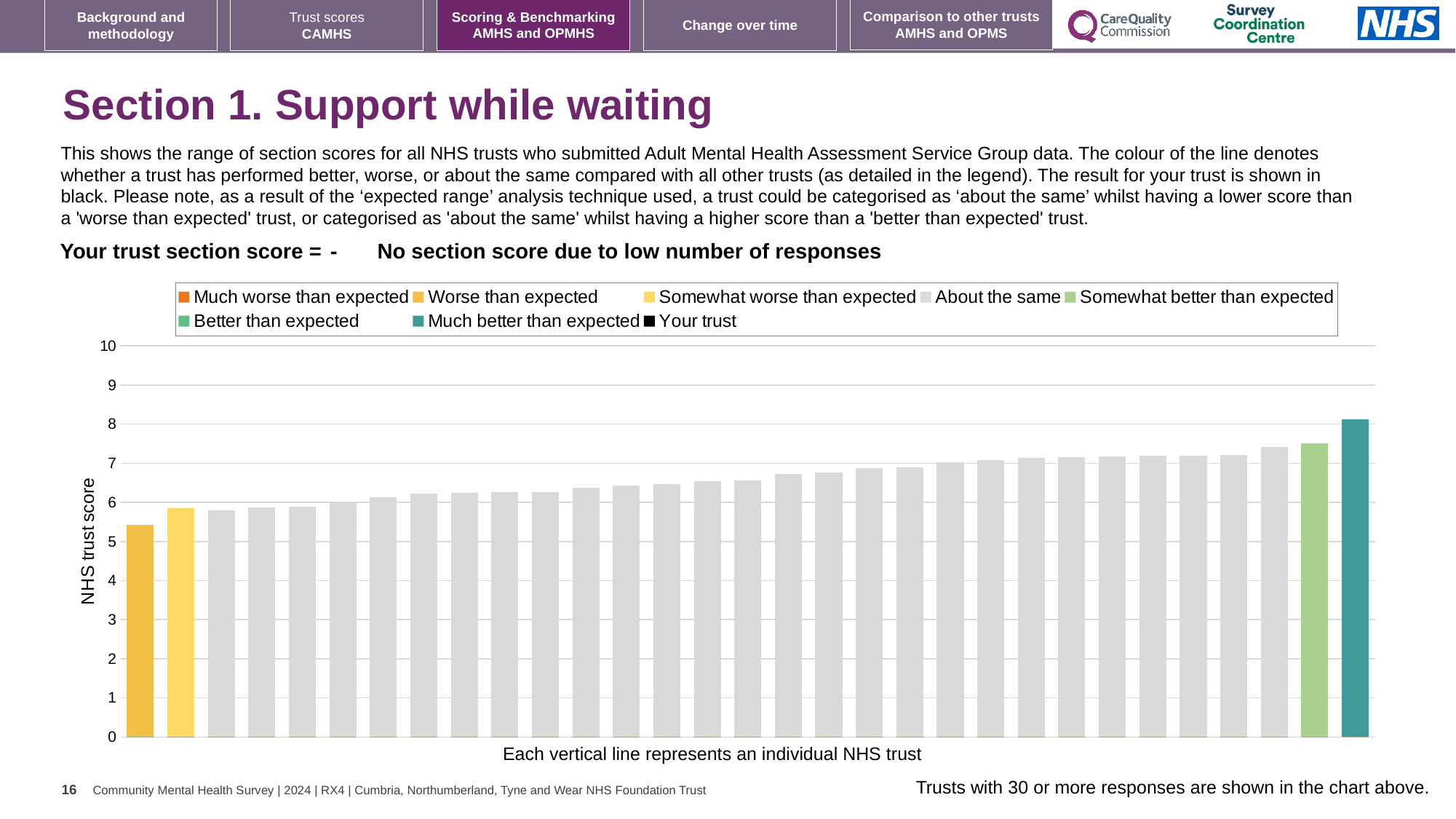
Is the value of the light green bar greater or less than 7? greater What is the label on the vertical axis of the chart? NHS trust score How many entries does the chart legend list? 8 Which legend category does the highest bar in the chart belong to? Much better than expected Is the value of the leftmost (orange) bar greater or less than 6? less Which legend category does the lowest bar in the chart belong to? Worse than expected Which is larger, the orange bar or the teal bar? the teal bar Is the value of the leftmost (orange) bar greater or less than 5? greater Do the bar values rise or fall from left to right across the chart? rise How many bars (trusts) are plotted in the chart? 31 What kind of chart is shown on the slide? bar chart